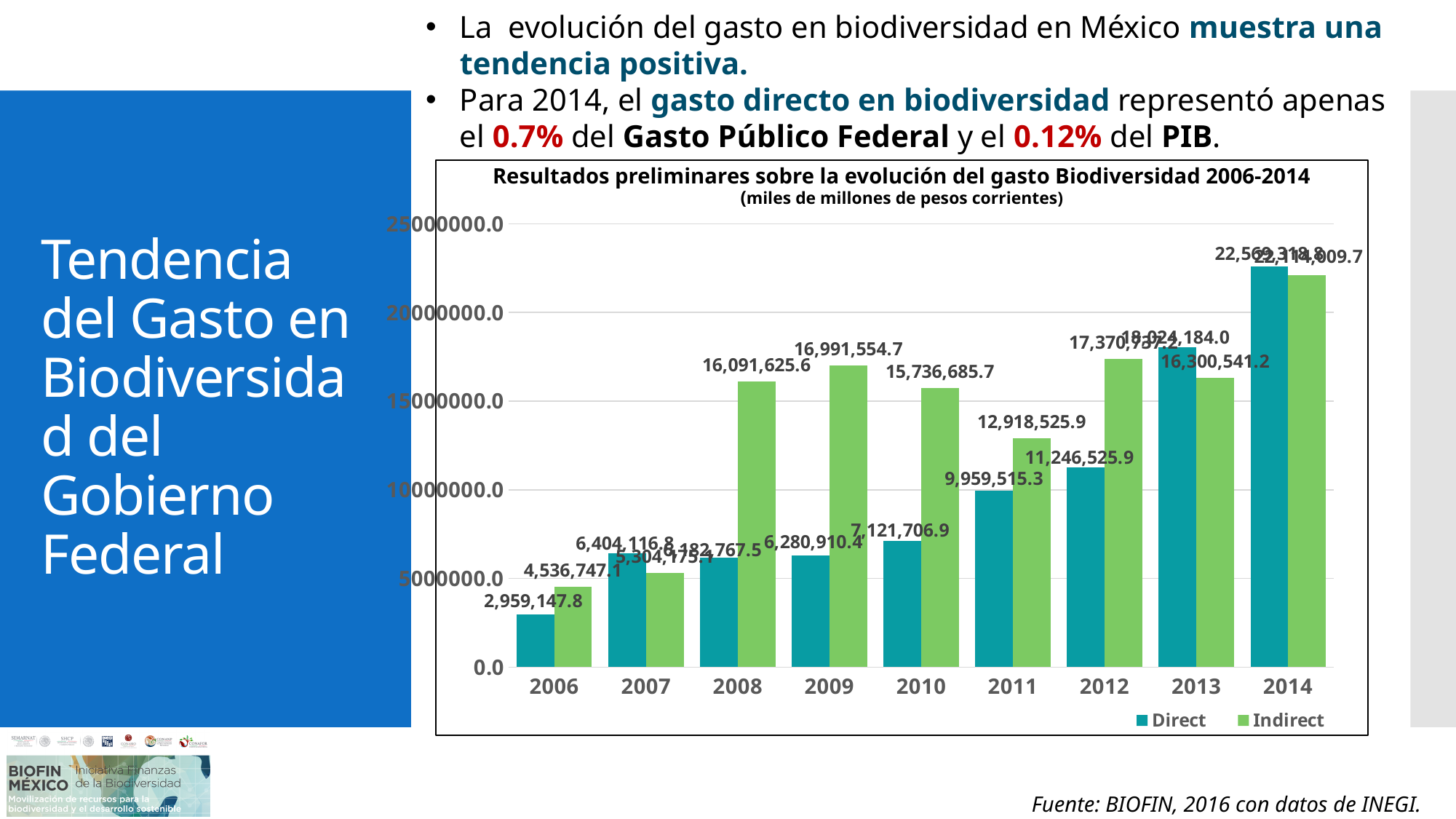
What kind of chart is shown on the slide? bar chart Is the Indirect value for 2008 greater or less than 15000000.0? greater What is the Direct value for 2011? 9,959,515.3 How many series does the chart legend list? 2 In 2013, which is larger, the Direct or the Indirect value? Direct In which year is the Direct value lowest? 2006 What is the difference between the Indirect and Direct values in 2011? 2,959,010.6 In which year is the Indirect value highest? 2014 How many years are shown on the x axis of the chart? 9 What is the Direct value for 2006? 2,959,147.8 What is the Indirect value for 2009? 16,991,554.7 What is the Indirect value for 2010? 15,736,685.7